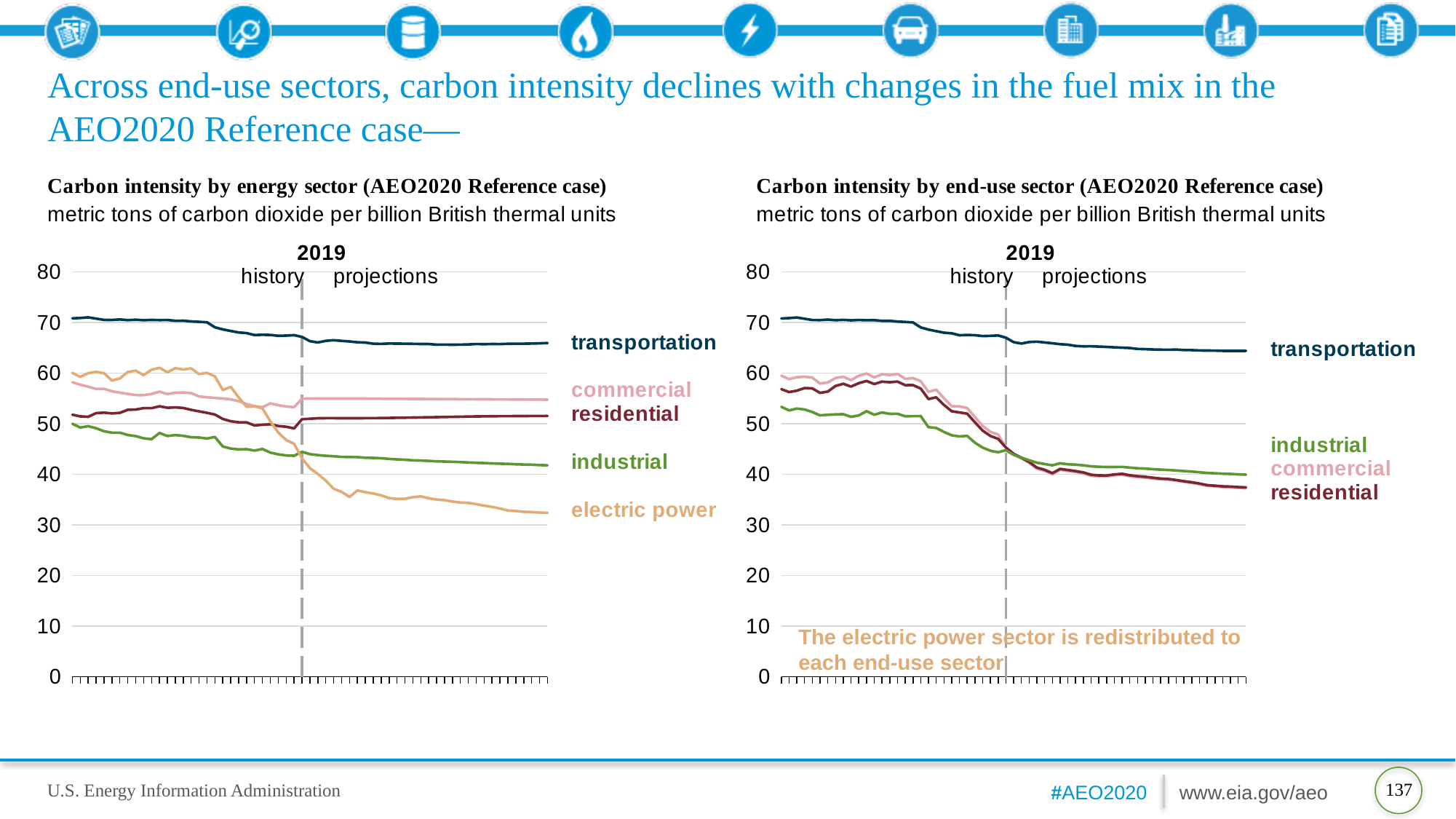
On the 'Carbon intensity by energy sector' chart on the left, which sector has the lowest carbon intensity at the end of the projection period? electric power On the 'Carbon intensity by end-use sector' chart on the right, which sector has the highest carbon intensity throughout the period? transportation On the 'Carbon intensity by energy sector' chart on the left, which sector has the highest carbon intensity throughout the period? transportation On the 'Carbon intensity by end-use sector' chart on the right, is the residential value at the end of the projection period greater or less than 40? less How many series are labelled on the 'Carbon intensity by energy sector' chart on the left? 5 What unit is carbon intensity measured in on both charts? metric tons of carbon dioxide per billion British thermal units On the 'Carbon intensity by energy sector' chart on the left, is the electric power value at the end of the projection period greater or less than 40? less On the 'Carbon intensity by energy sector' chart on the left, is the transportation value at the end of the projection period greater or less than 60? greater On the 'Carbon intensity by energy sector' chart on the left, does the electric power line rise or fall over the period shown? fall What year does the dashed vertical line separating history from projections mark on both charts? 2019 What kind of chart is the 'Carbon intensity by energy sector' chart on the left? line chart How many series are labelled on the 'Carbon intensity by end-use sector' chart on the right? 4